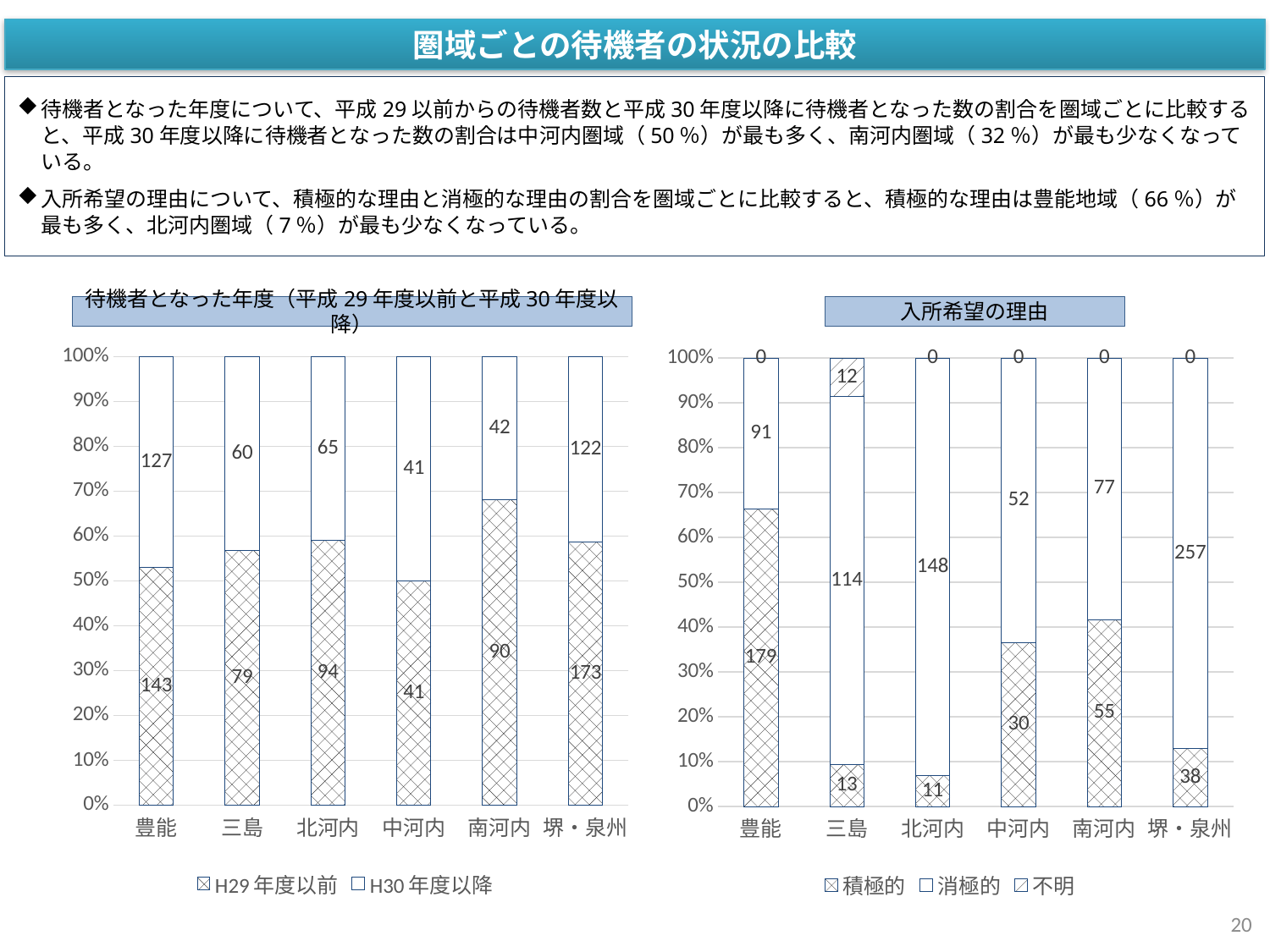
In the right chart (入所希望の理由), which category has the highest 積極的 value? 豊能 In the left chart (待機者となった年度), what is the total of the two values for 三島? 139 In the left chart (待機者となった年度), which category has the lowest H30年度以降 value? 中河内 In the right chart (入所希望の理由), what is the 不明 value for 三島? 12 In the right chart (入所希望の理由), is the 積極的 value for 北河内 or for 中河内 larger? 中河内 In the left chart (待機者となった年度), what is the H30年度以降 value for 南河内? 42 In the left chart (待機者となった年度), which category has the highest H29年度以前 value? 堺・泉州 In the left chart (待機者となった年度), what is the H29年度以前 value for 堺・泉州? 173 In the right chart (入所希望の理由), what is the 消極的 value for 堺・泉州? 257 In the right chart (入所希望の理由), how many series does the legend list? 3 In the left chart (待機者となった年度), what is the difference between the H29年度以前 and H30年度以降 values for 豊能? 16 What kind of chart is the left chart (待機者となった年度)? Stacked bar chart